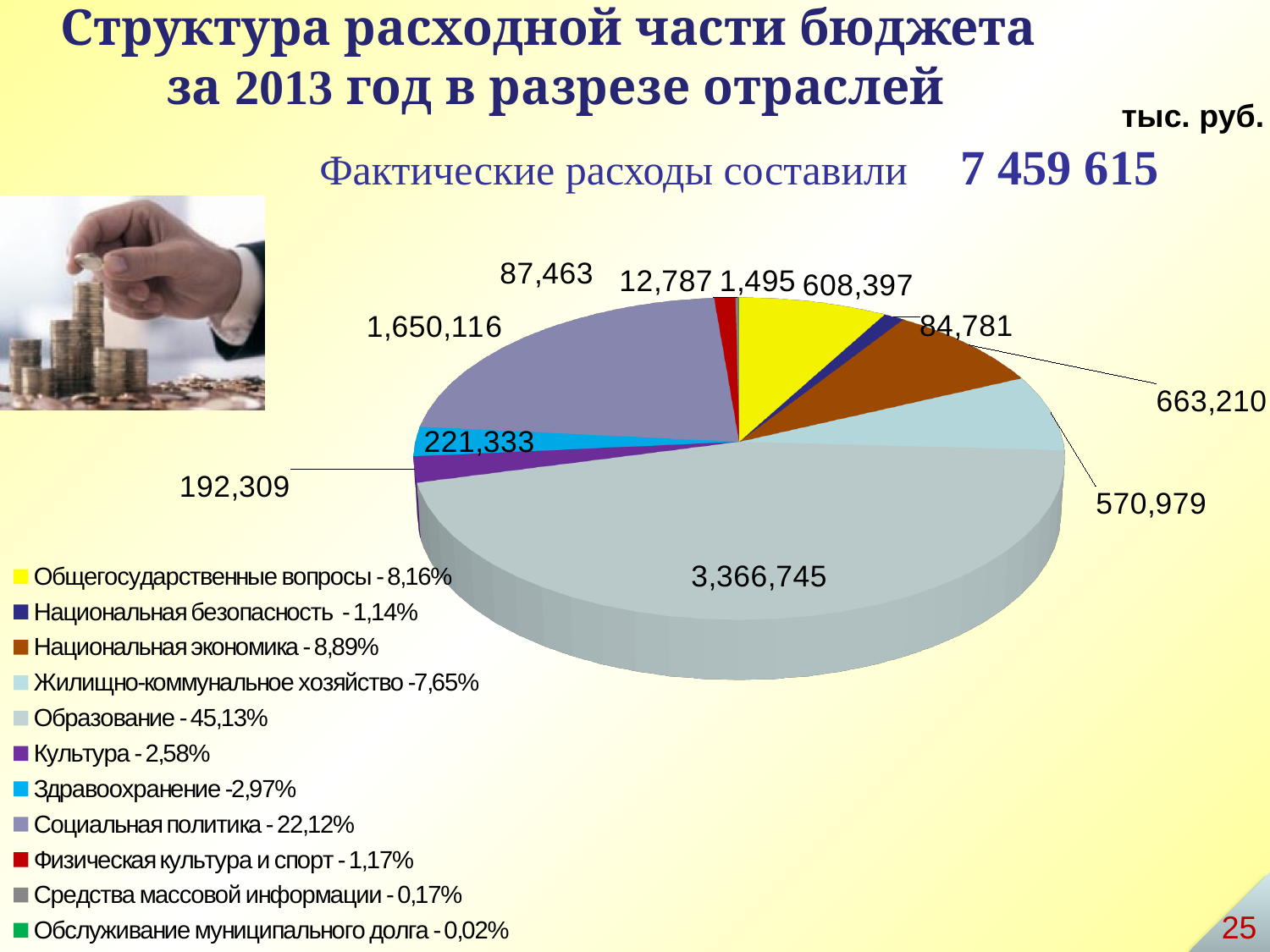
What is the difference between the values for Национальная экономика and Жилищно-коммунальное хозяйство? 92,231 How many categories does the legend of the pie chart list? 11 Which category has the largest slice of the pie chart? Образование What is the value for Образование in the pie chart? 3,366,745 What share of the pie does Социальная политика represent, according to the legend? 22,12% What is the value for Национальная экономика in the pie chart? 663,210 Which category has the smallest slice of the pie chart? Обслуживание муниципального долга What total of actual expenditures is stated on the slide? 7 459 615 Which is larger in the pie chart: Общегосударственные вопросы or Национальная экономика? Национальная экономика What type of chart is shown on the slide? pie chart What share of the pie does Жилищно-коммунальное хозяйство represent, according to the legend? 7,65% What is the value for Социальная политика in the pie chart? 1,650,116